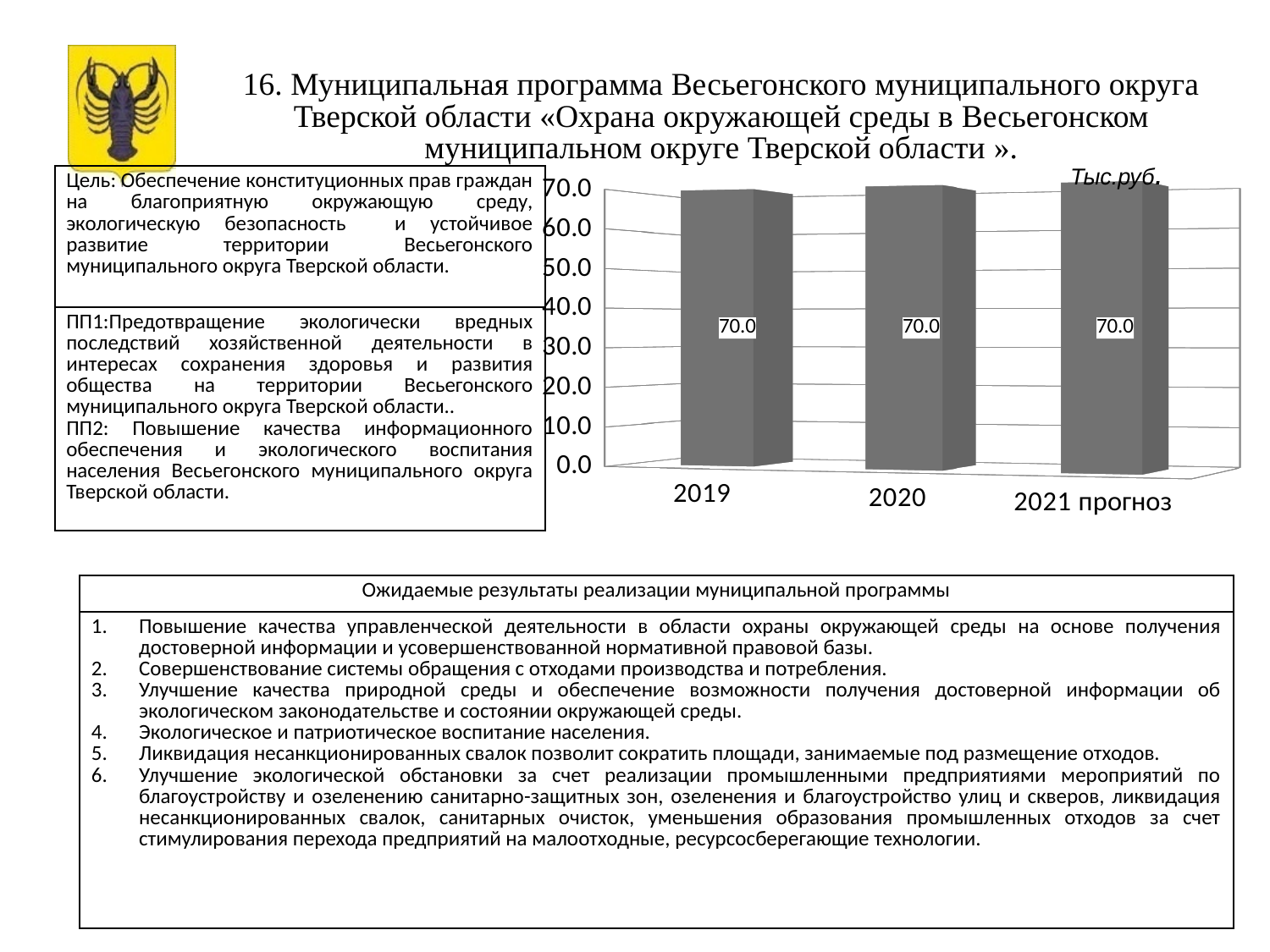
Is the value for 2021 прогноз greater or less than 60.0? greater What is the value for 2021 прогноз? 70.0 Do the values rise, fall or stay the same from 2019 to 2021 прогноз? stay the same What is the difference between the values for 2020 and 2019? 0.0 How many categories are shown on the x axis of the chart? 3 What is the label of the last category on the x axis? 2021 прогноз What unit label is shown above the chart? Тыс.руб. Is the value for 2019 greater or less than 50.0? greater What is the value for 2020? 70.0 What is the value for 2019? 70.0 What kind of chart is shown on the slide? bar chart